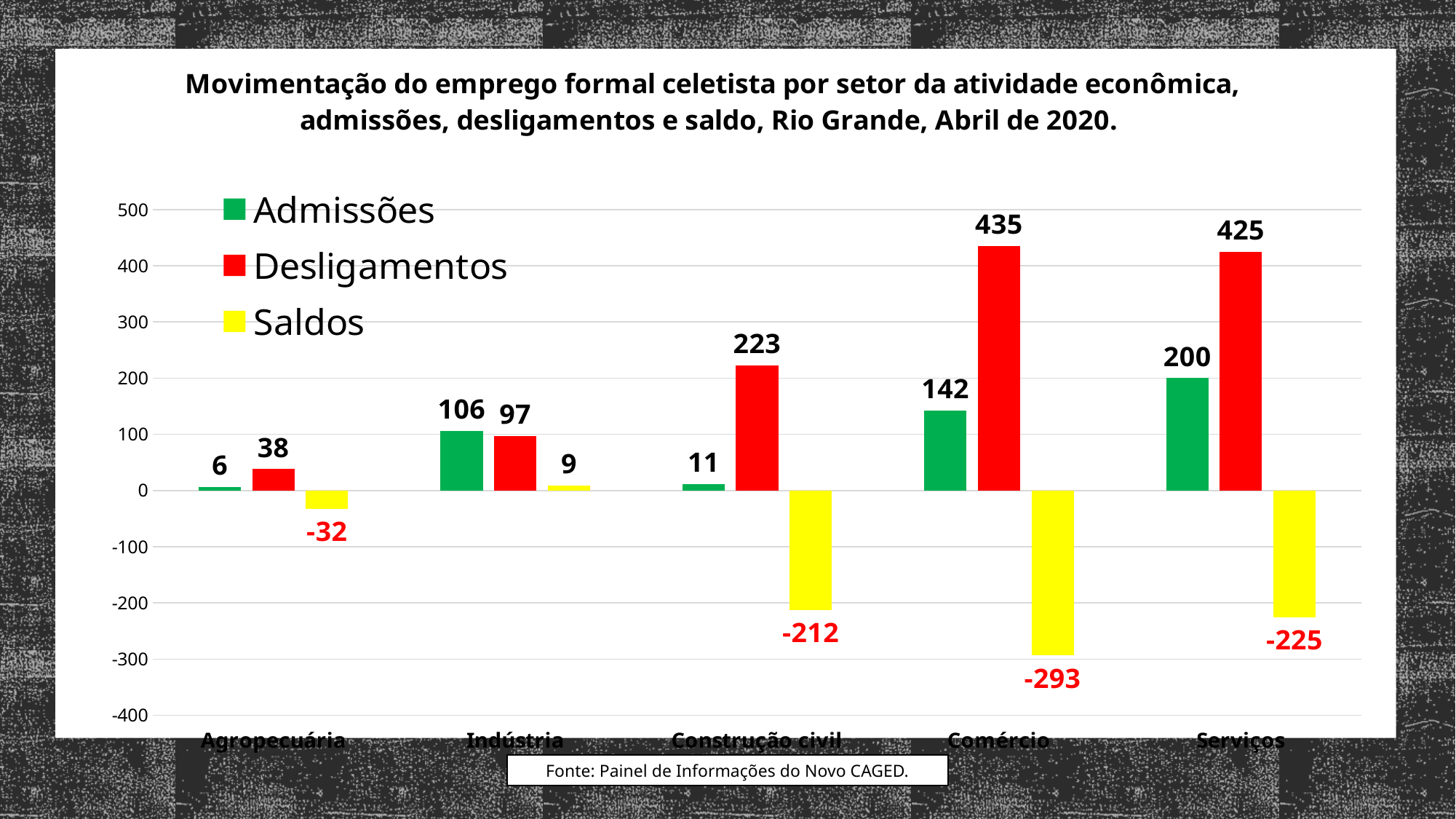
What is the Admissões value for Comércio? 142 Which sector has the lowest Admissões value? Agropecuária What colour represents the Saldos series in the legend? Yellow What is the Desligamentos value for Serviços? 425 How many series does the legend list? 3 Which sector has the highest Desligamentos value? Comércio Which sector has the lowest Saldos value? Comércio What is the difference between Desligamentos and Admissões for Indústria? 9 What kind of chart is shown on the slide? Bar chart Which is larger for Construção civil: Admissões or Desligamentos? Desligamentos How many sectors are shown on the x axis? 5 What is the Saldos value for Construção civil? -212